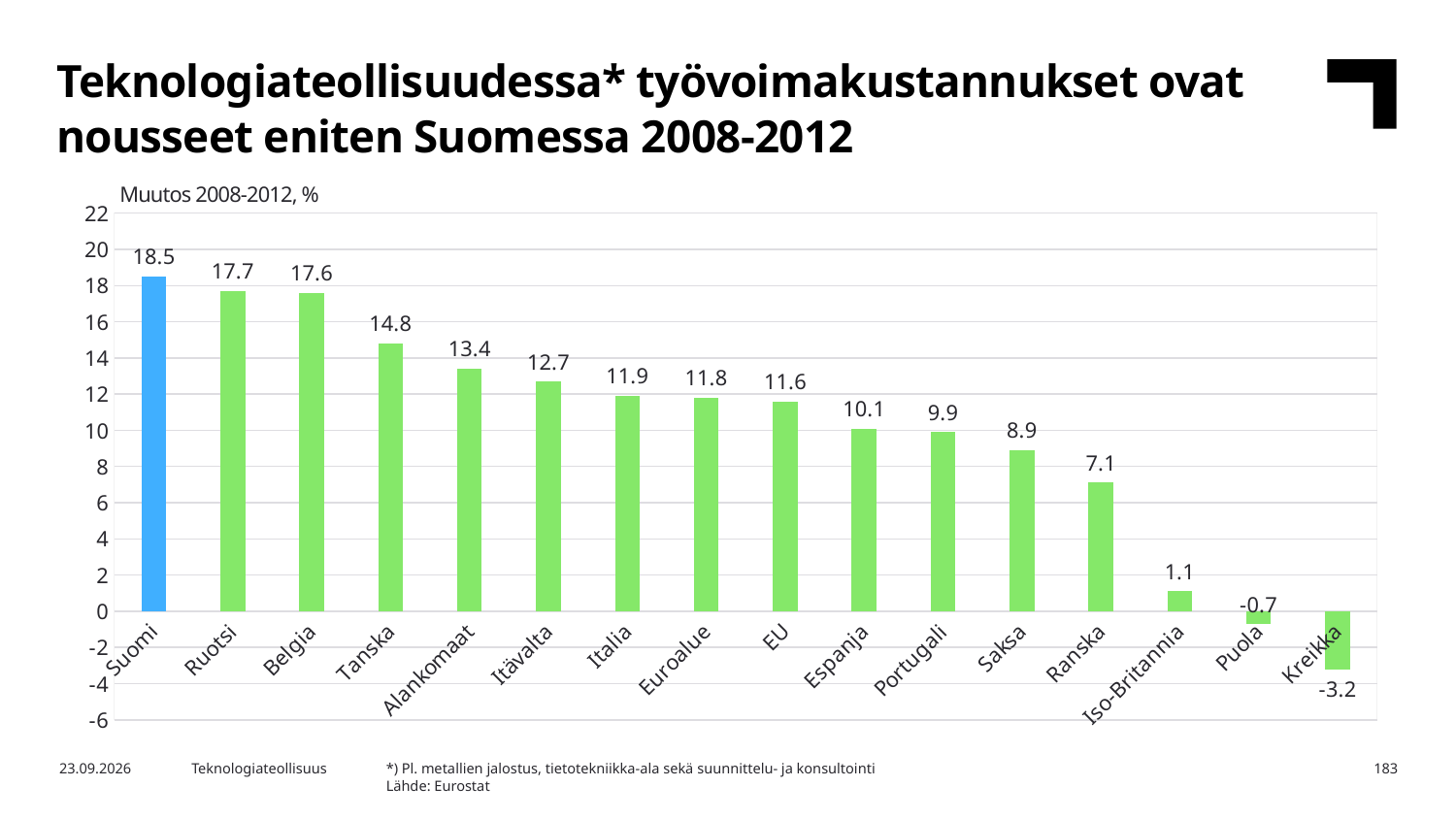
What is the difference between the values for Tanska and Saksa? 5.9 Do the values rise or fall from left to right along the x axis? Fall What is the difference between the values for Suomi and Ruotsi? 0.8 Which category has the lowest value? Kreikka Which is larger, the value for Espanja or the value for Ranska? Espanja What kind of chart is shown on the slide? Bar chart What is the value for Iso-Britannia? 1.1 Which country has the highest value? Suomi What is the value for Kreikka? -3.2 What is the value for Alankomaat? 13.4 How many categories are shown on the x axis? 16 What is the value for Suomi? 18.5